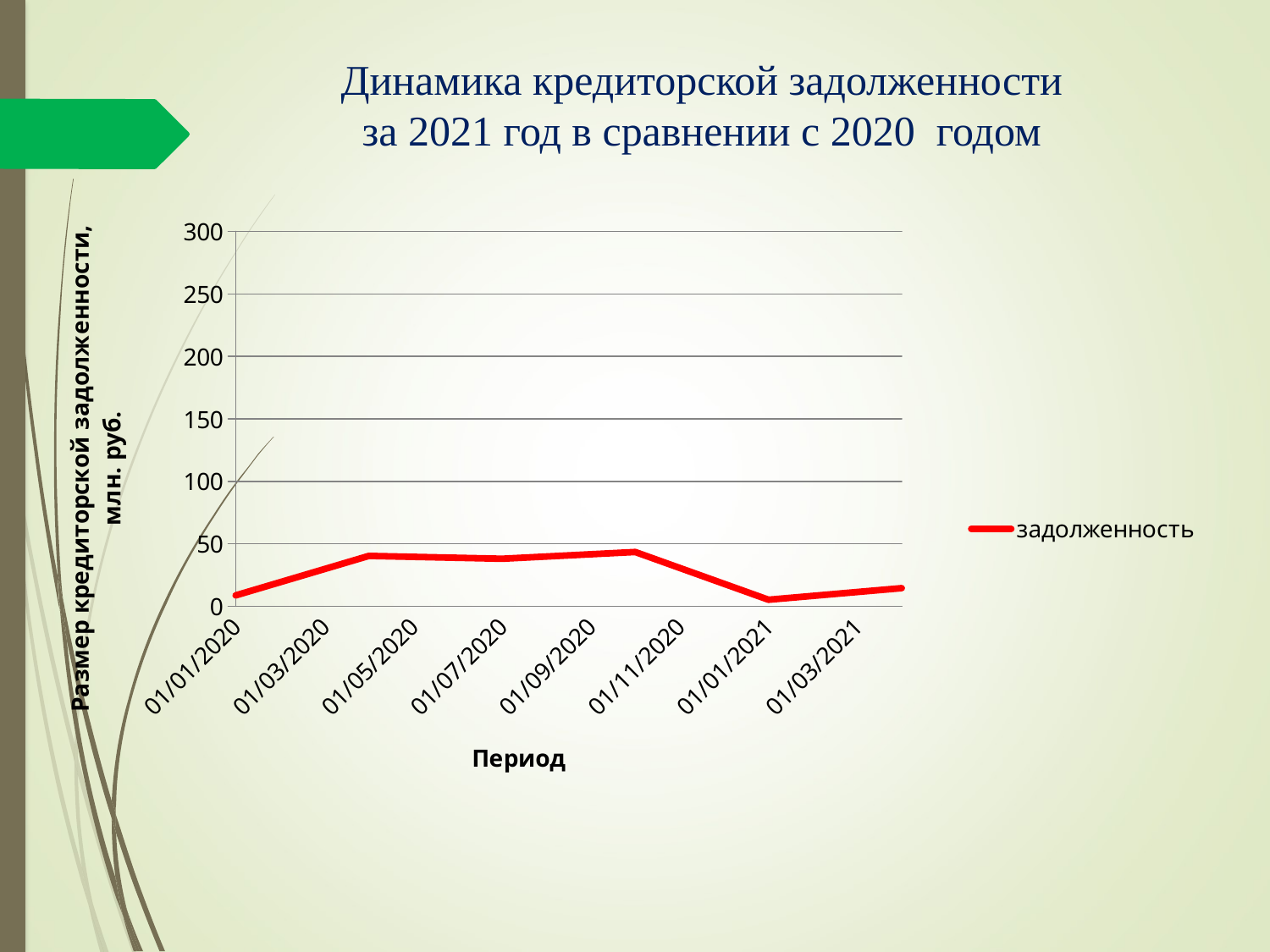
How many series does the legend list? 1 What is the title of the x axis? Период Is the value for 01/07/2020 greater or less than 50? less Which is larger, the value for 01/07/2020 or the value for 01/01/2020? 01/07/2020 Is the value for 01/01/2021 greater or less than 50? less How many date labels are shown on the x axis? 8 Is the value for 01/07/2020 greater or less than 100? less What kind of chart is shown on the slide? line chart Which is larger, the value for 01/07/2020 or the value for 01/01/2021? 01/07/2020 Does the line rise or fall between 01/07/2020 and 01/01/2021? fall What is the name of the series shown in the legend? задолженность